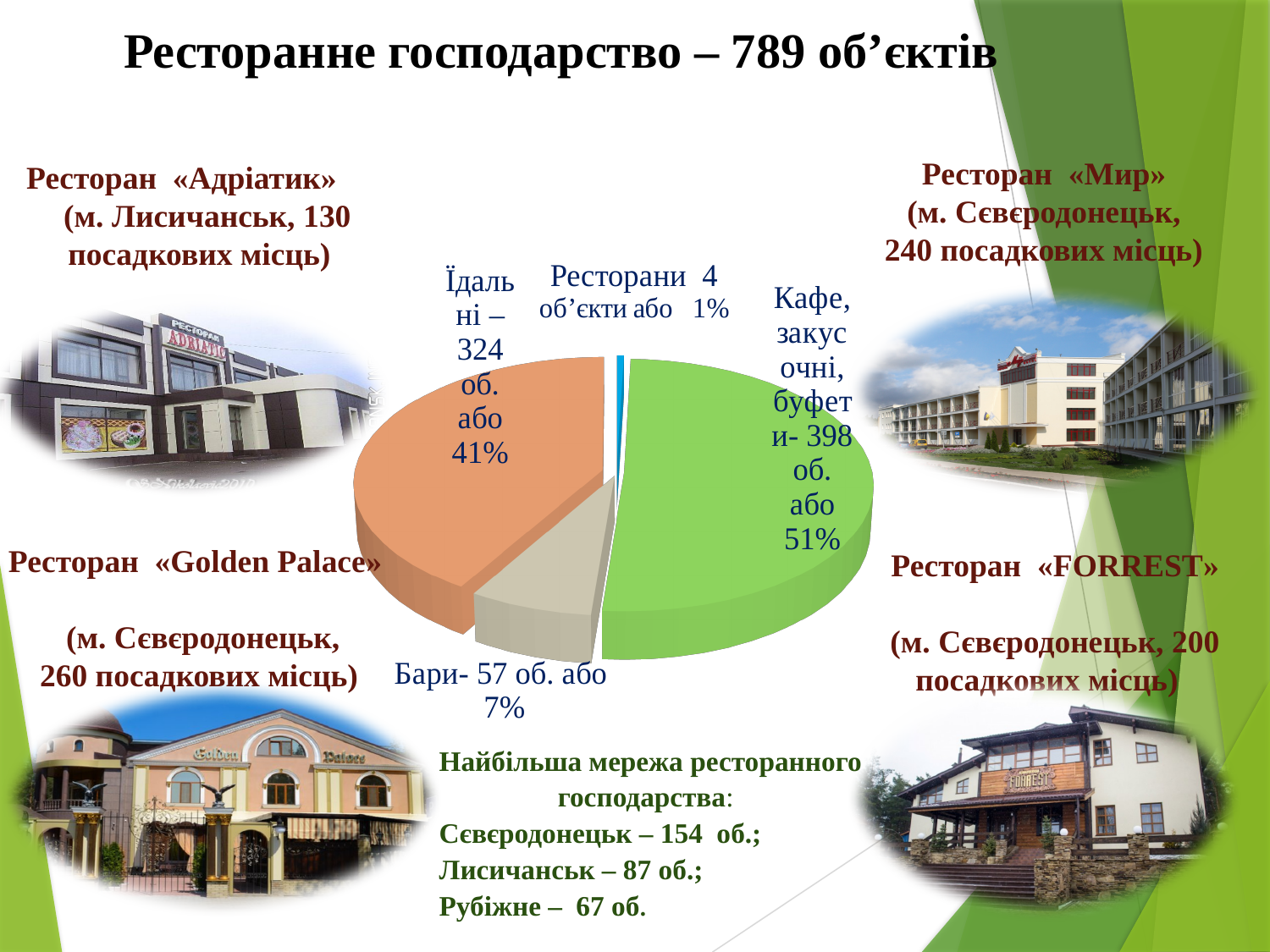
How many slices does the pie chart have? 4 What share of the pie do "Їдальні" make up? 41% How many objects are in the "Їдальні" category? 324 об. How many objects are in the "Бари" category? 57 об. What kind of chart is shown on the slide? pie chart How many objects are in the "Ресторани" category? 4 об'єкти Which has more objects, "Бари" or "Ресторани"? Бари What share of the pie do "Бари" make up? 7% Which category has the smallest slice of the pie? Ресторани How many objects are in the "Кафе, закусочні, буфети" category? 398 об. What is the difference in the number of objects between "Кафе, закусочні, буфети" and "Їдальні"? 74 Which category has the largest slice of the pie? Кафе, закусочні, буфети